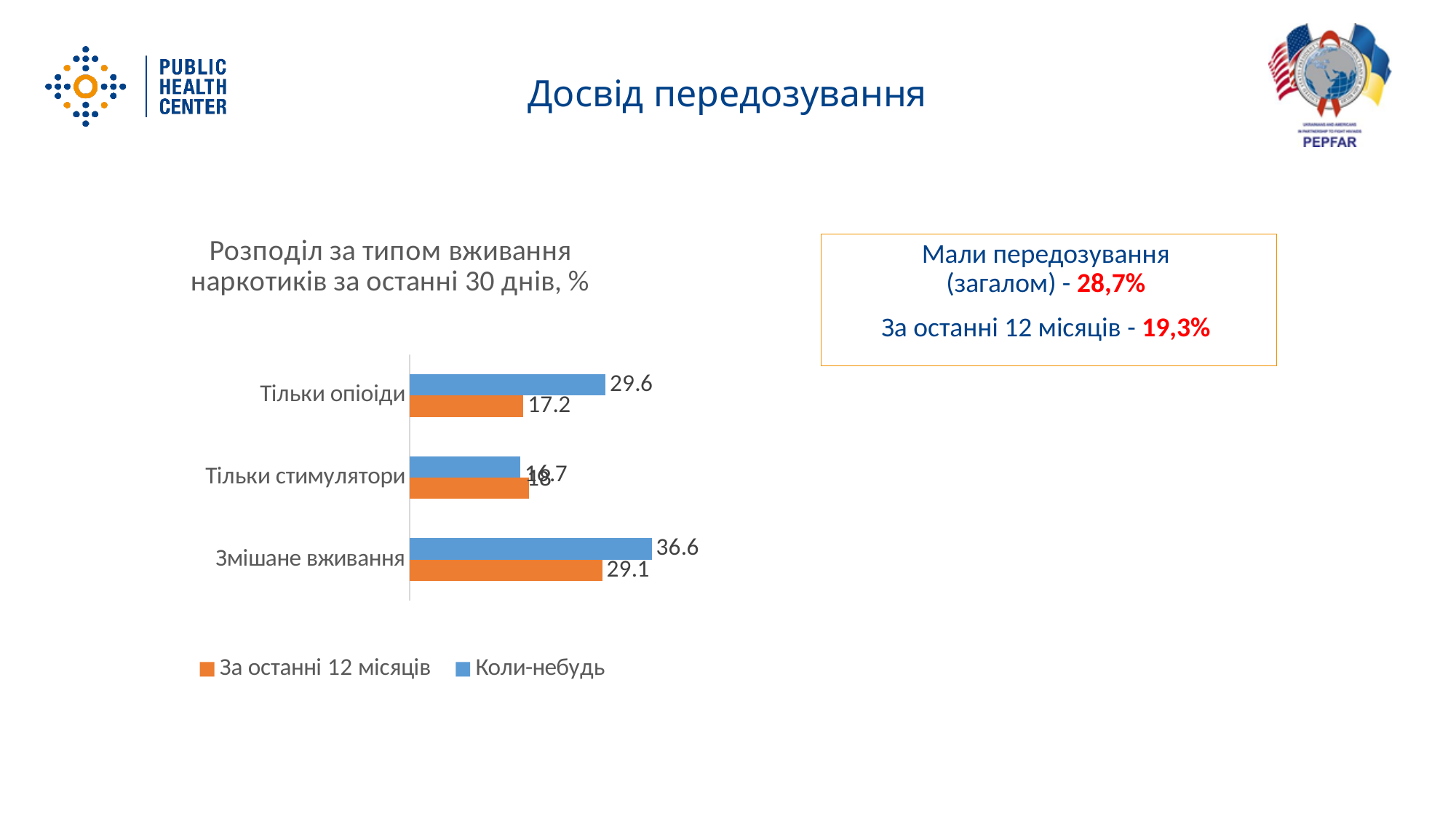
Which category has the highest value for the 'Коли-небудь' series? Змішане вживання What is the value for 'Коли-небудь' in the 'Тільки опіоіди' category? 29.6 How many categories are shown on the chart? 3 Which category has the highest value for the 'За останні 12 місяців' series? Змішане вживання What is the value for 'За останні 12 місяців' in the 'Тільки опіоіди' category? 17.2 What is the value for 'Коли-небудь' in the 'Змішане вживання' category? 36.6 For the 'Коли-небудь' series, which is larger: 'Тільки опіоіди' or 'Змішане вживання'? Змішане вживання What is the difference between the 'Коли-небудь' and 'За останні 12 місяців' values for 'Змішане вживання'? 7.5 How many series does the legend list? 2 What kind of chart is shown on the slide? Bar chart What is the difference between the 'Коли-небудь' and 'За останні 12 місяців' values for 'Тільки опіоіди'? 12.4 What is the value for 'За останні 12 місяців' in the 'Змішане вживання' category? 29.1